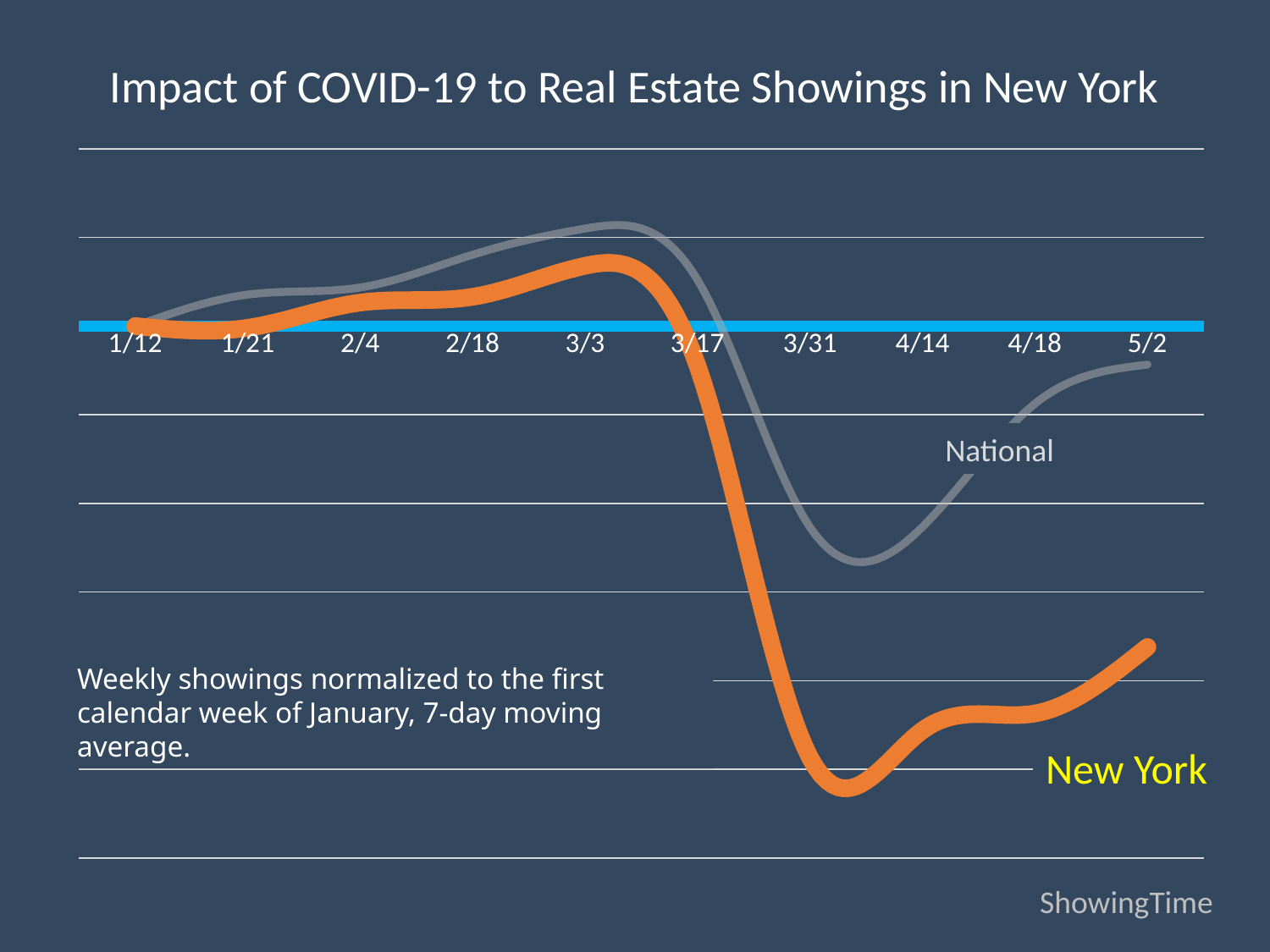
Does the New York line rise or fall between 3/17 and 3/31? Fall What are the names of the two series plotted on the chart? National and New York Which series is lower at 3/31, National or New York? New York How many series are plotted on the chart? 2 Does the National line rise or fall between 1/12 and 3/3? Rise How many date labels are shown along the x axis? 10 What is the title of the chart? Impact of COVID-19 to Real Estate Showings in New York Does the New York line rise or fall between 3/31 and 5/2? Rise Which series reaches the highest point on the chart? National Which series is higher at 5/2, National or New York? National What kind of chart is shown on the slide? Line chart Which series reaches the lowest point on the chart? New York